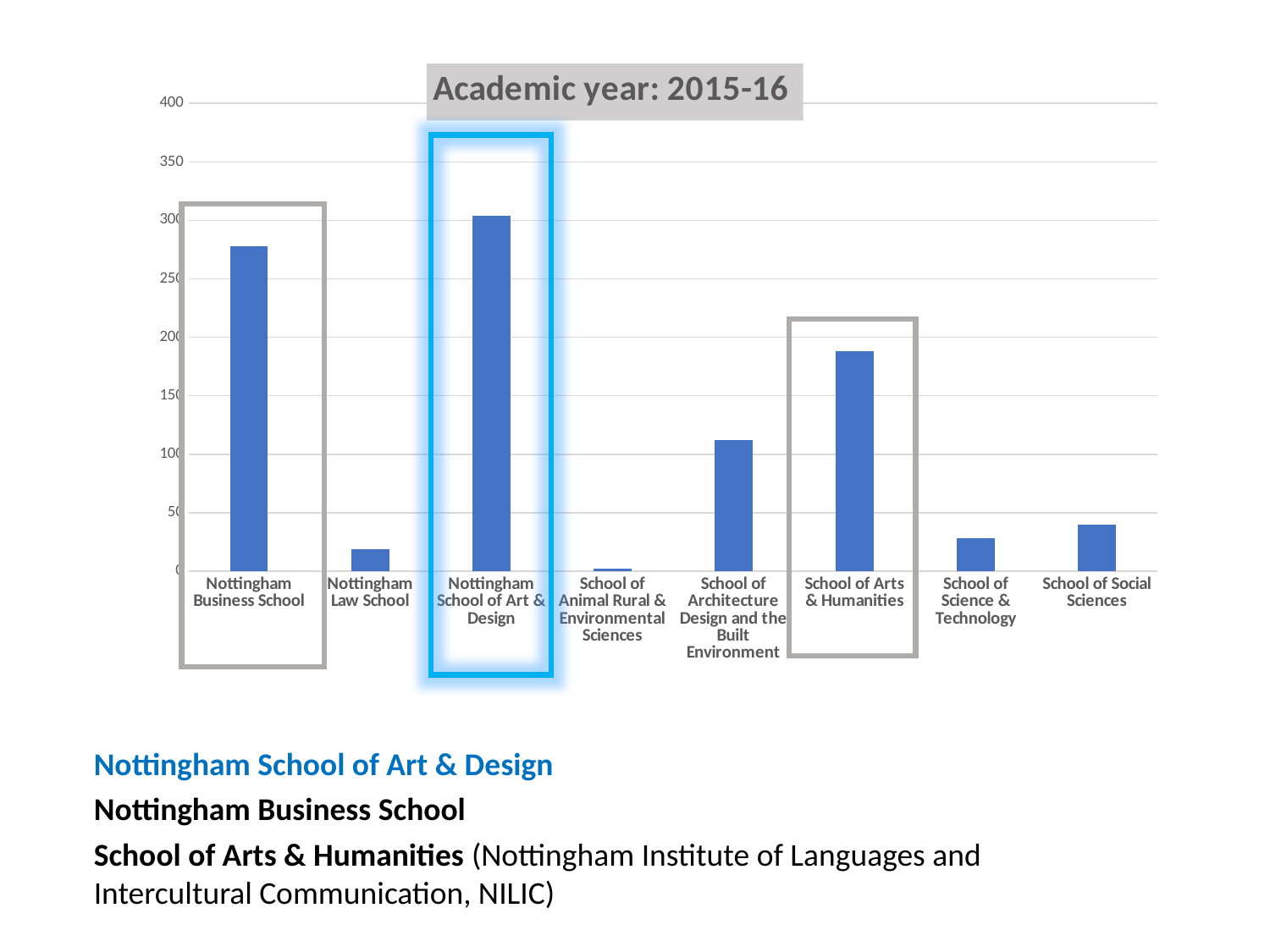
Which is larger, the value for School of Architecture Design and the Built Environment or the value for School of Social Sciences? School of Architecture Design and the Built Environment What kind of chart is shown on the slide? Bar chart Is the value for School of Architecture Design and the Built Environment greater or less than 100? greater Is the value for School of Arts & Humanities greater or less than 200? less Which school has the highest bar in the chart? Nottingham School of Art & Design How many schools are shown on the x axis of the chart? 8 Is the value for Nottingham Law School greater or less than 50? less Which school has the lowest bar in the chart? School of Animal Rural & Environmental Sciences Which is larger, the value for Nottingham Business School or the value for School of Arts & Humanities? Nottingham Business School Which school's bar is highlighted with a blue box on the chart? Nottingham School of Art & Design What is the title of the chart? Academic year: 2015-16